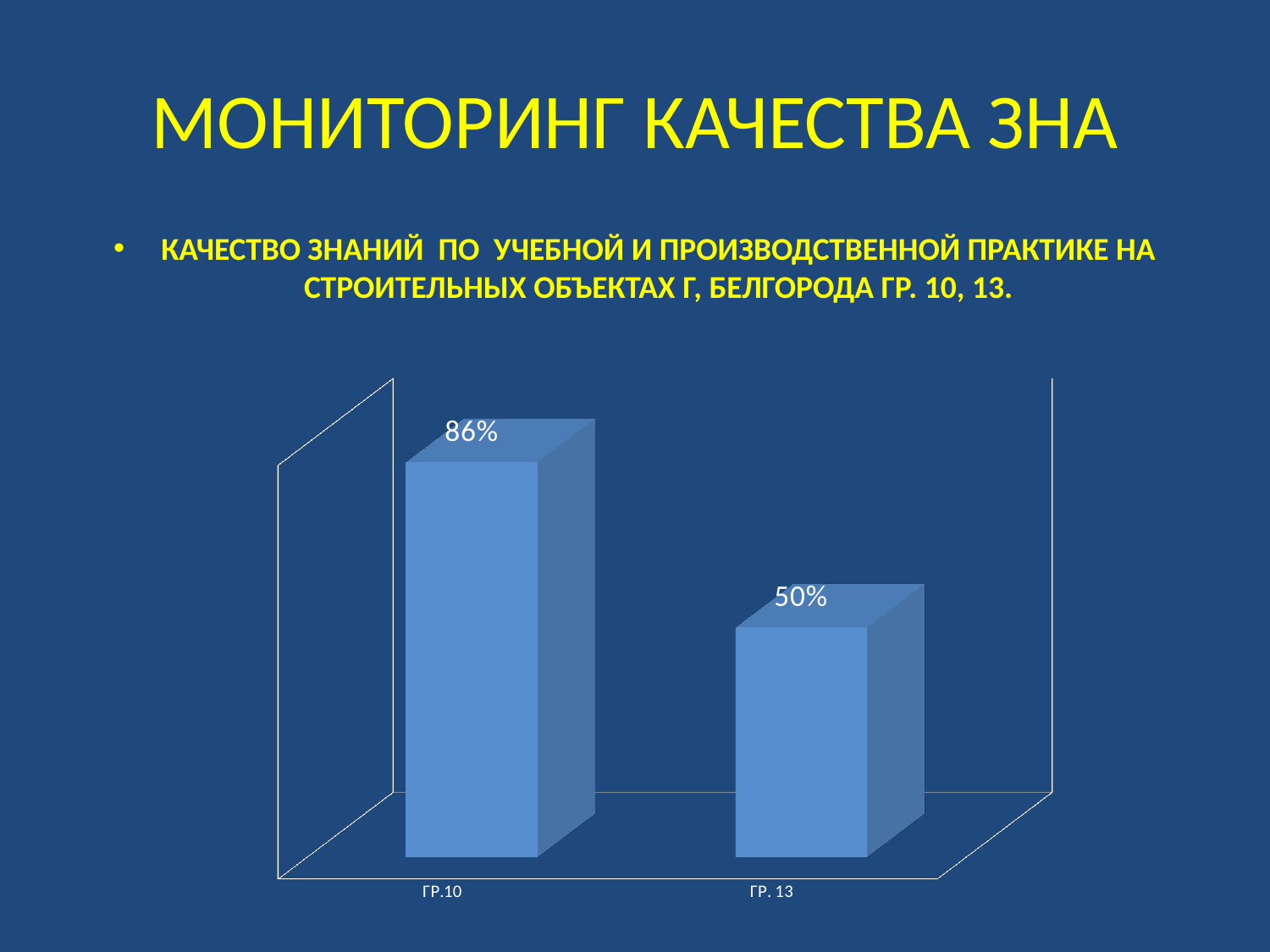
What is the value for ГР. 13? 50% What is the difference between the values for ГР.10 and ГР. 13? 36% What is the value for ГР.10? 86% Which category has the highest value? ГР.10 How many categories are shown in the chart? 2 What kind of chart is shown on the slide? bar chart What is the title of the slide? МОНИТОРИНГ КАЧЕСТВА ЗНА What colour are the bars in the chart? blue Which category has the lowest value? ГР. 13 Do the values rise or fall from ГР.10 to ГР. 13? fall Which is larger, the value for ГР.10 or the value for ГР. 13? ГР.10